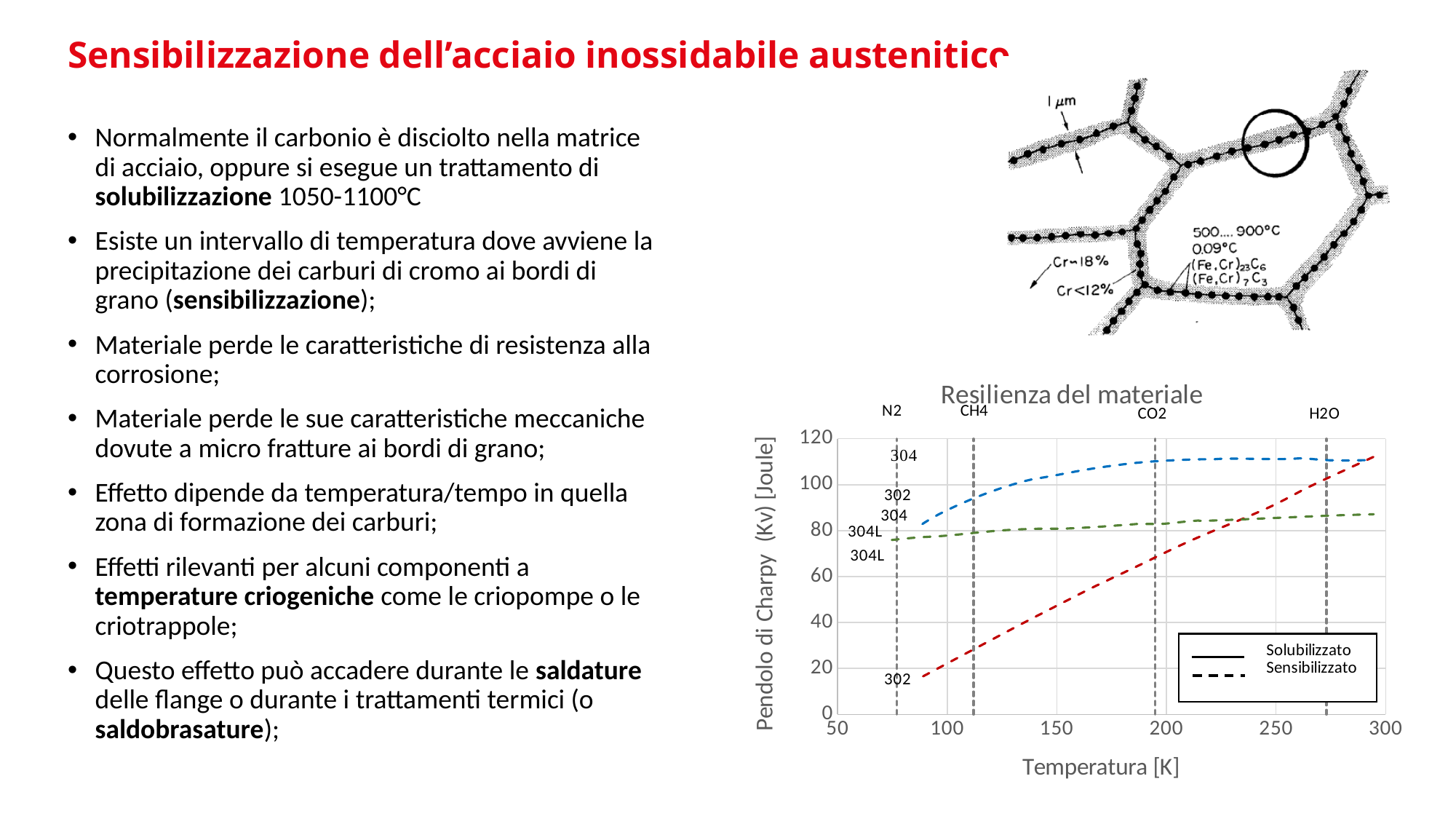
In the 'Resilienza del materiale' chart, is the value of the green 304L curve at 150 K greater or less than 60? greater In the 'Resilienza del materiale' chart, is the value of the red 302 curve at 100 K greater or less than 40? less What is the x-axis label of the 'Resilienza del materiale' chart? Temperatura [K] In the 'Resilienza del materiale' chart, which curve has the highest value at 200 K? 304 (blue) In the 'Resilienza del materiale' chart, is the value of the red 302 curve at 250 K greater or less than 80? greater In the 'Resilienza del materiale' chart, which curve has the higher value at 150 K, the blue 304 curve or the red 302 curve? blue 304 curve What kind of chart is 'Resilienza del materiale'? line chart What is the title of the chart on the slide? Resilienza del materiale How many curves are plotted in the 'Resilienza del materiale' chart? 3 In the 'Resilienza del materiale' chart, does the red 302 curve rise or fall as temperature increases? rise In the 'Resilienza del materiale' chart, which curve has the lowest value at 100 K? 302 (red)